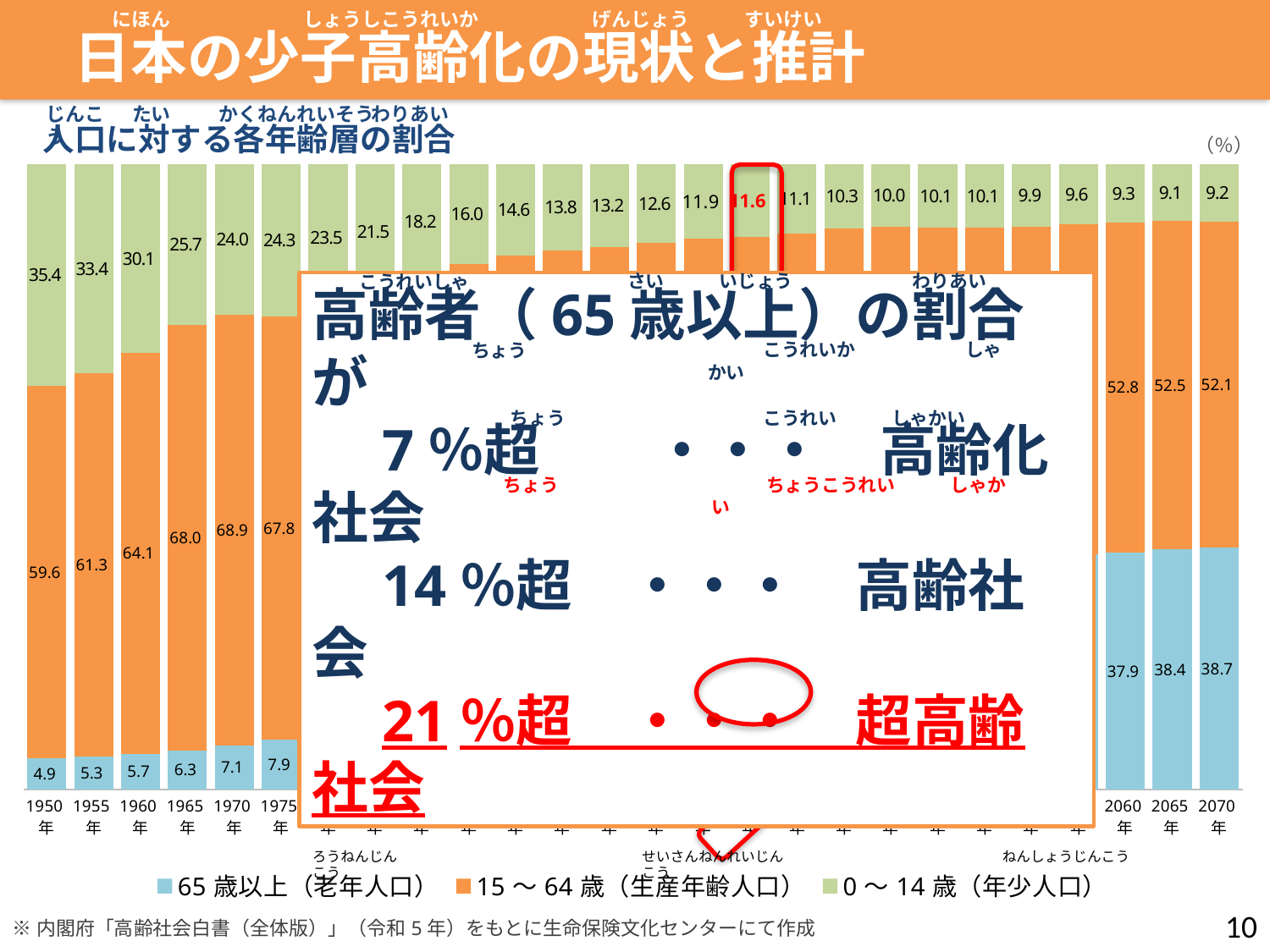
What kind of chart is shown on the slide? Stacked bar chart What is the value for the 0～14歳 (年少人口) series in 2070? 9.2 What is the difference between the 65歳以上 (老年人口) value in 2070 and in 1950? 33.8 What is the value for the 65歳以上 (老年人口) series in 2065? 38.4 Among the years 1950, 1955, 1960, 1965, 1970 and 1975, which year has the highest value for the 15～64歳 (生産年齢人口) series? 1970年 Which is larger: the 0～14歳 (年少人口) value in 1950 or in 2070? 1950年 What is the total of the stacked bar for 2070? 100.0 What is the value for the 65歳以上 (老年人口) series in 1950? 4.9 Does the value for the 0～14歳 (年少人口) series rise or fall from 1950 to 2070? Fall Among the years 2060, 2065 and 2070, which year has the lowest value for the 0～14歳 (年少人口) series? 2065年 What is the value for the 15～64歳 (生産年齢人口) series in 1970? 68.9 How many series does the legend list? 3